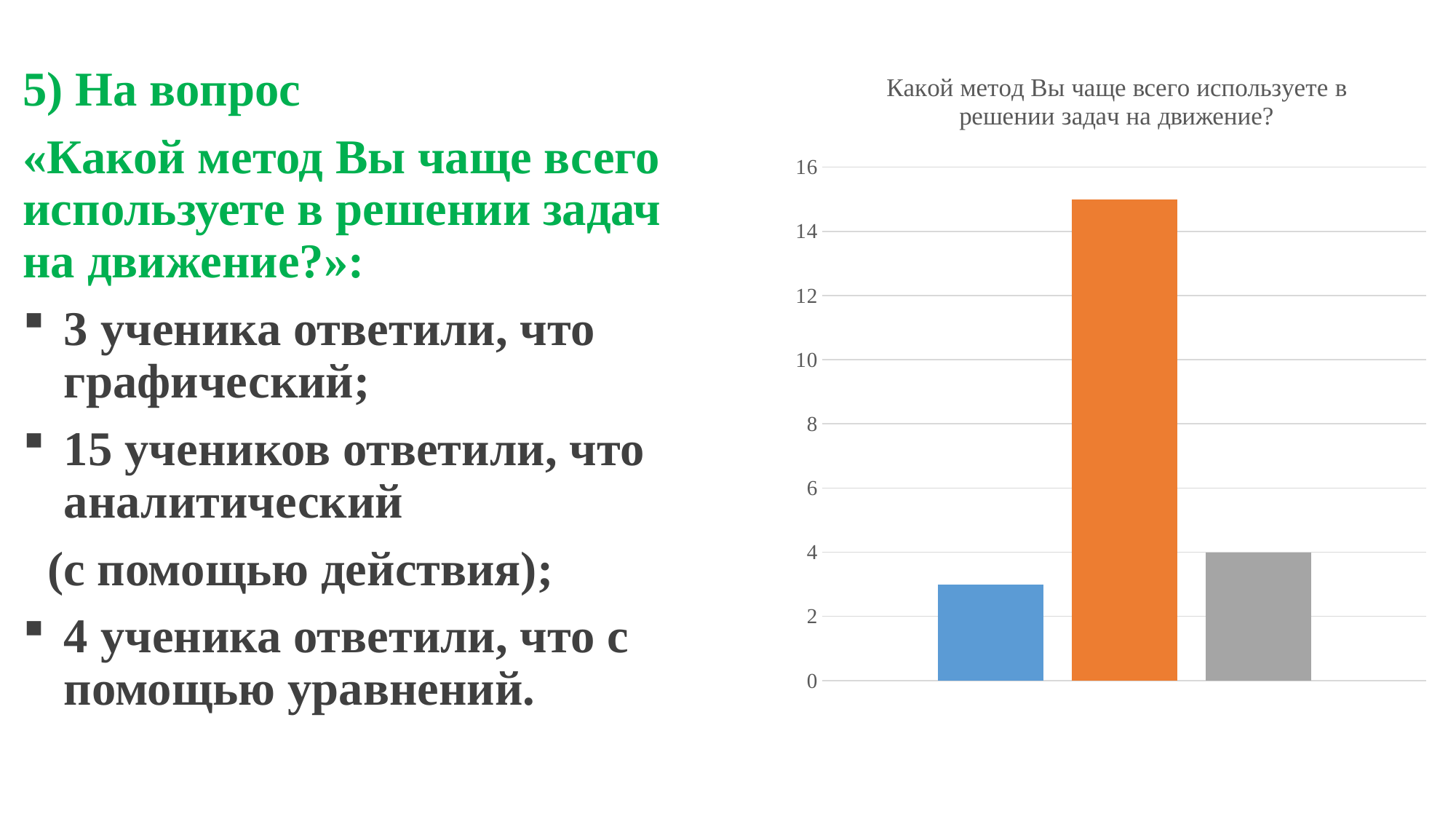
What kind of chart is shown on the slide? bar chart How many bars are plotted in the chart? 3 Is the value of the orange (middle) bar greater or less than 14? greater What is the title of the chart? Какой метод Вы чаще всего используете в решении задач на движение? What is the highest value shown on the vertical axis of the chart? 16 Which bar is the shortest in the chart? the blue (left) bar Is the value of the orange (middle) bar greater or less than 16? less Which bar is the tallest in the chart? the orange (middle) bar Is the value of the blue (left) bar greater or less than 2? greater Which is larger, the orange (middle) bar or the gray (right) bar? the orange (middle) bar What value does the gray (right) bar reach on the vertical axis? 4